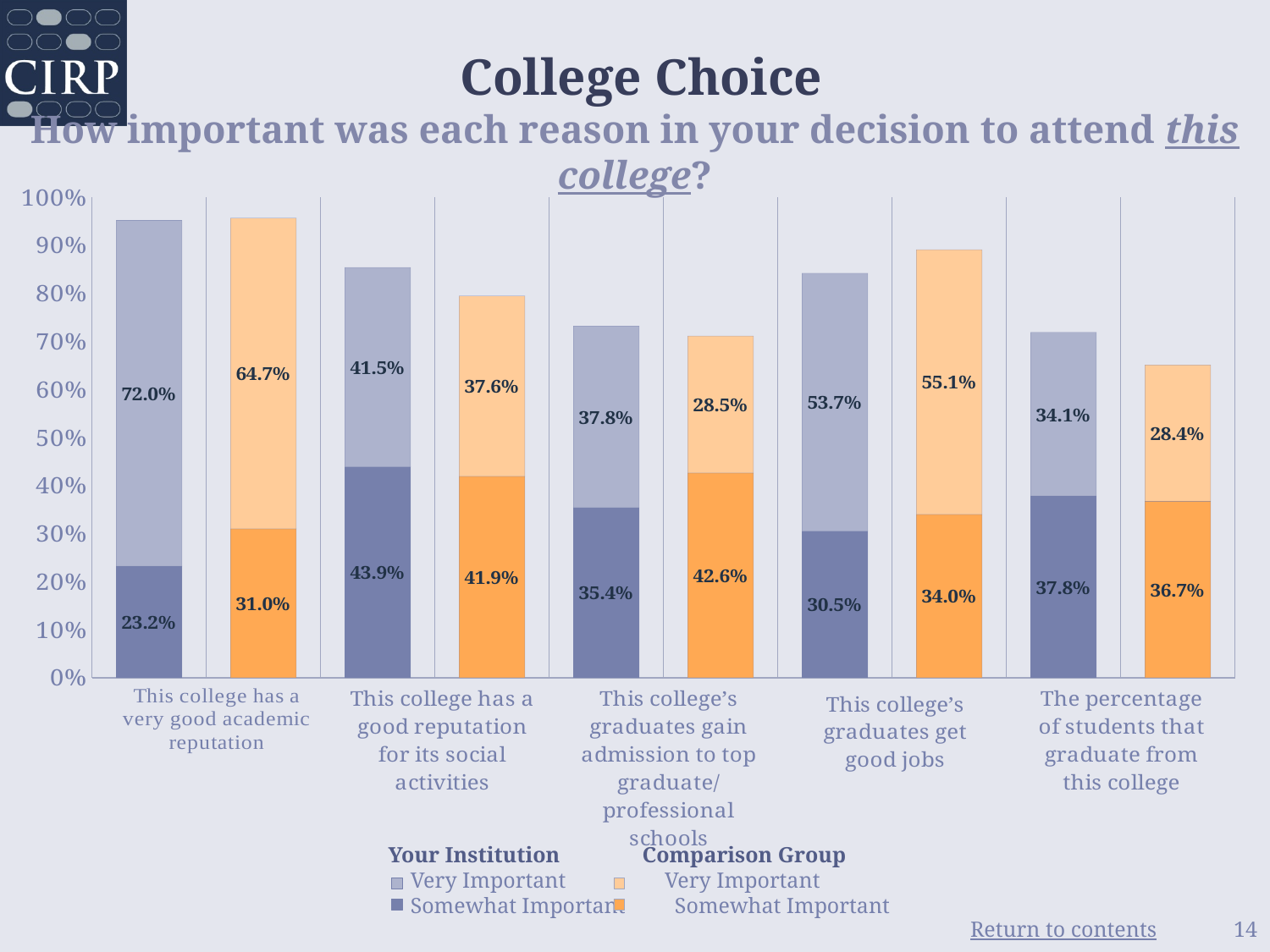
What is the difference between the Your Institution and Comparison Group Very Important percentages for 'This college has a very good academic reputation'? 7.3% How many reasons (categories) are shown on the x axis? 5 What is the total of the Comparison Group stacked bar for 'This college's graduates get good jobs'? 89.1% For 'This college's graduates gain admission to top graduate/professional schools', which is larger: the Comparison Group Somewhat Important value or the Your Institution Somewhat Important value? Comparison Group Somewhat Important What kind of chart is shown on the slide? Stacked bar chart What percentage of Your Institution students rated 'The percentage of students that graduate from this college' as Very Important? 34.1% How many series does the legend list? 4 What percentage of the Comparison Group rated 'This college's graduates get good jobs' as Somewhat Important? 34.0% Which reason has the lowest Very Important percentage for the Comparison Group? The percentage of students that graduate from this college What is the total of the Your Institution stacked bar for 'This college has a good reputation for its social activities'? 85.4% What percentage of Your Institution students rated 'This college has a very good academic reputation' as Very Important? 72.0% Which reason has the highest Very Important percentage for Your Institution? This college has a very good academic reputation